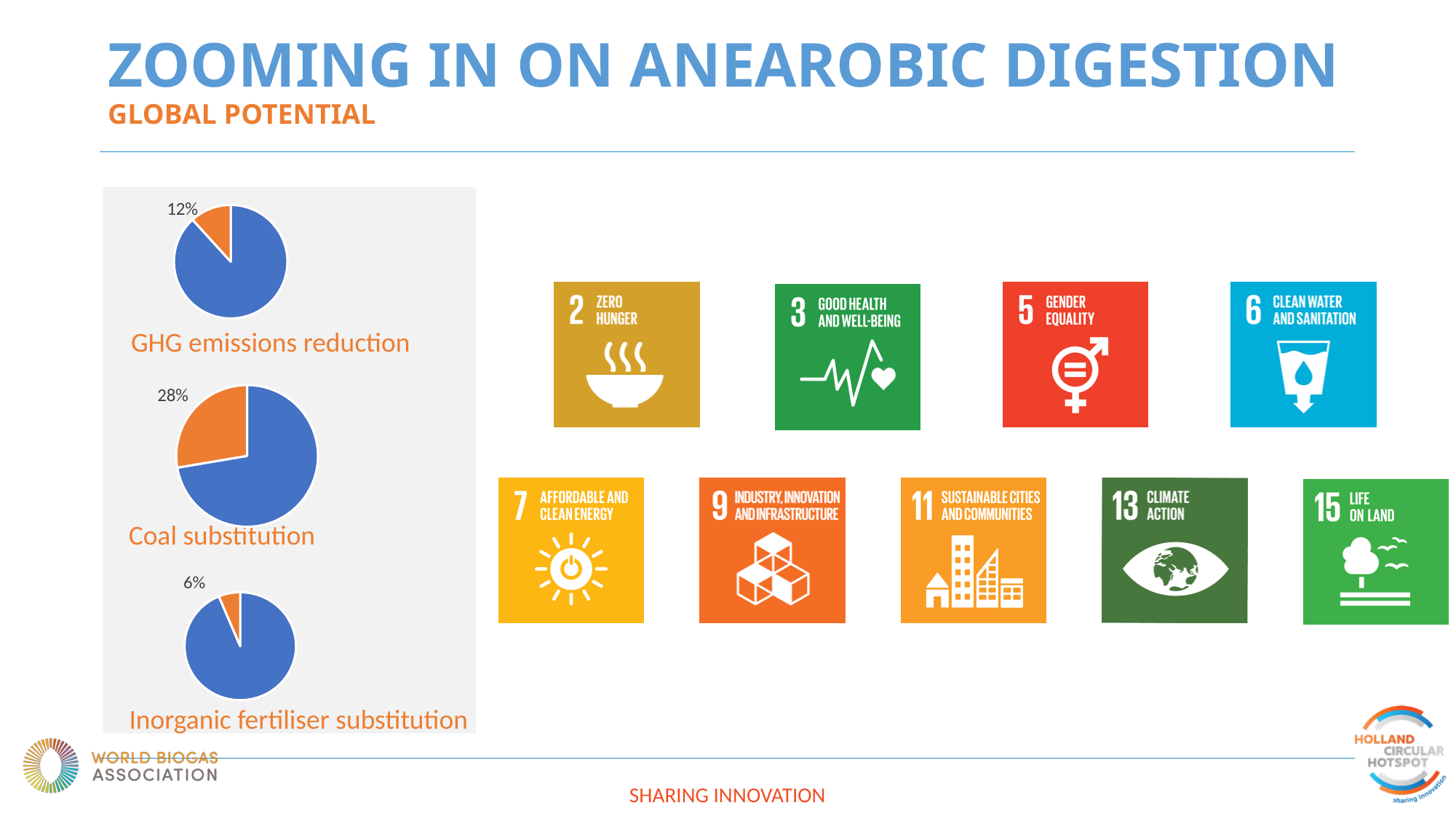
What is the difference between the labelled percentages for GHG emissions reduction and Inorganic fertiliser substitution? 6% How many slices does the Coal substitution pie chart have? 2 In the Inorganic fertiliser substitution pie chart, what percentage is shown for the orange slice? 6% Which labelled percentage is larger: GHG emissions reduction or Inorganic fertiliser substitution? GHG emissions reduction Across the three pie charts, which category has the smallest labelled percentage? Inorganic fertiliser substitution In the pie charts, what colour is the slice that carries the percentage label? Orange What is the difference between the labelled percentages for Coal substitution and GHG emissions reduction? 16% In the Coal substitution pie chart, what percentage is shown for the orange slice? 28% How many pie charts are shown on the slide? 3 In the GHG emissions reduction pie chart, what percentage is shown for the orange slice? 12% What type of chart is used to show the GHG emissions reduction, Coal substitution and Inorganic fertiliser substitution figures? Pie chart Across the three pie charts, which category has the largest labelled percentage? Coal substitution